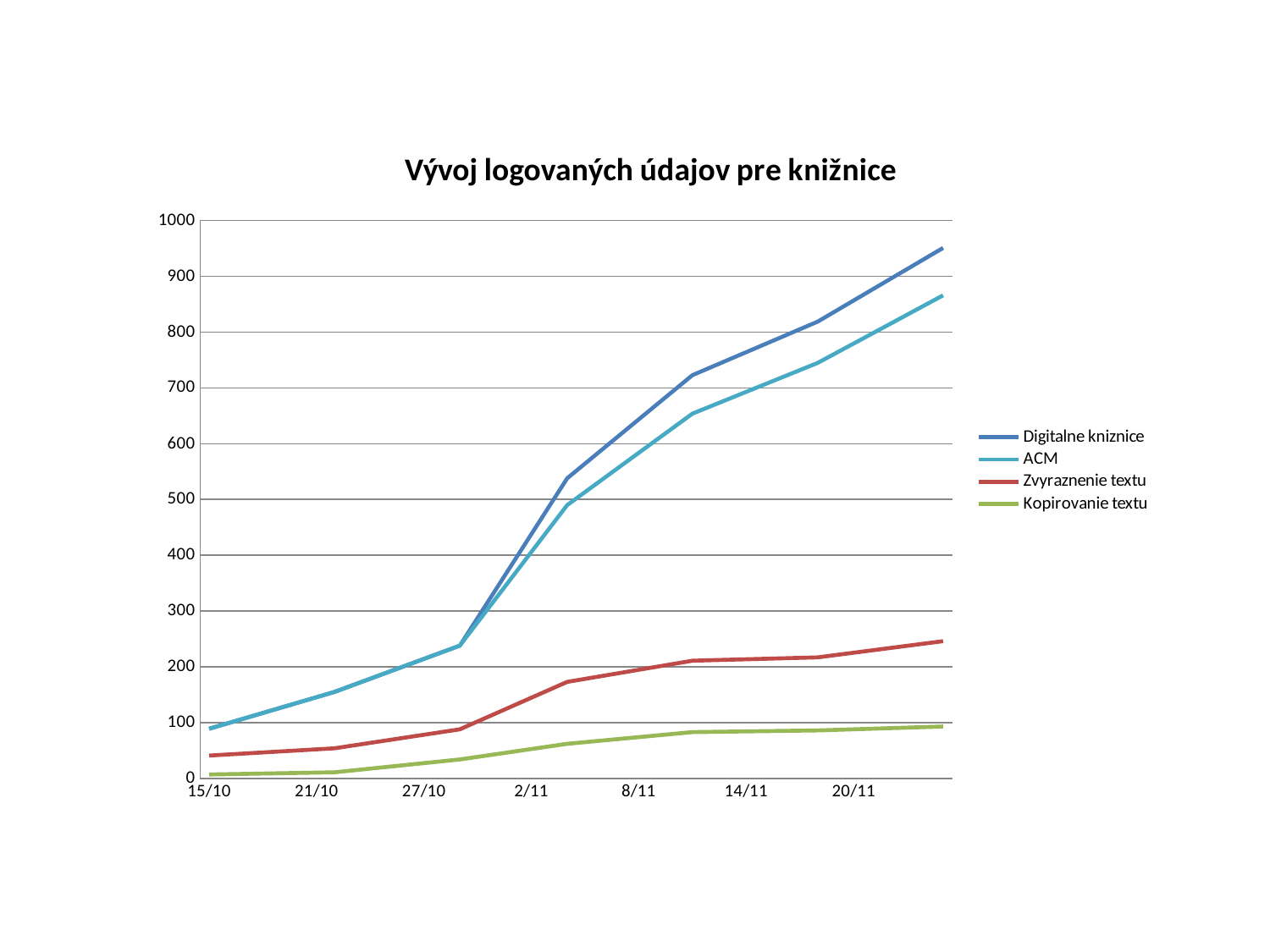
Which series stays lowest across the chart? Kopirovanie textu Which series is drawn in green in the legend? Kopirovanie textu Is the final value for ACM greater or less than 800? greater What kind of chart is shown on the slide? line chart Is the final value for Kopirovanie textu greater or less than 100? less Which series reaches the highest value on the chart? Digitalne kniznice How many date labels are shown on the x axis? 7 How many series does the legend list? 4 What is the title of the chart? Vývoj logovaných údajov pre knižnice Is the final value for Digitalne kniznice greater or less than 900? greater At the last point on the chart, which is larger: Digitalne kniznice or ACM? Digitalne kniznice Do the values for Digitalne kniznice rise or fall along the x axis? rise